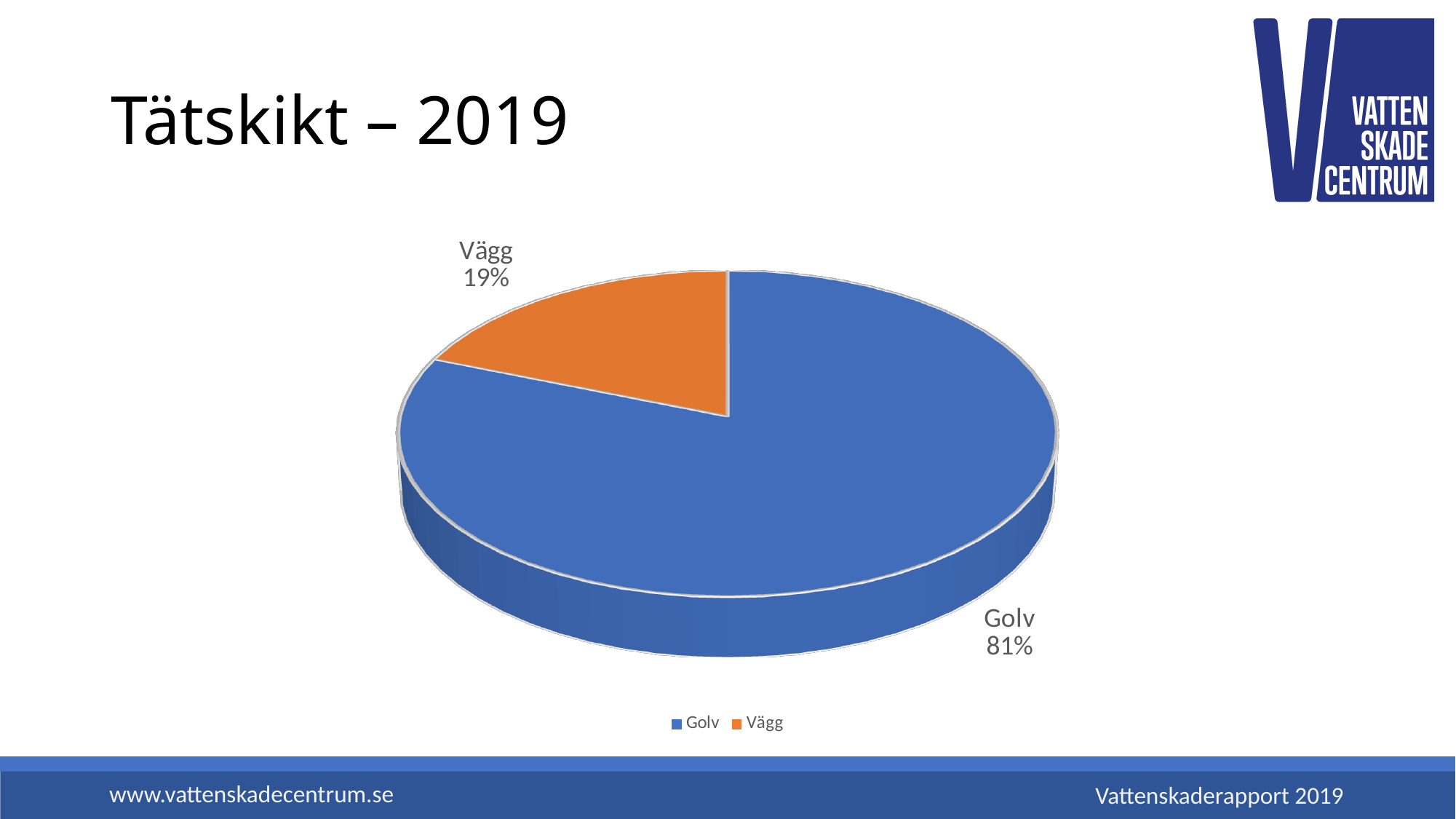
What share of the pie does Vägg represent? 19% What is the title of the slide containing the chart? Tätskikt – 2019 Which category has the smallest slice of the pie? Vägg What colour is the Vägg slice? Orange What kind of chart is shown on the slide? Pie chart What is the difference in percentage points between Golv and Vägg? 62 Which is larger, the share for Golv or the share for Vägg? Golv How many categories are shown in the pie chart? 2 Which category has the largest slice of the pie? Golv What share of the pie does Golv represent? 81% How many entries does the legend list? 2